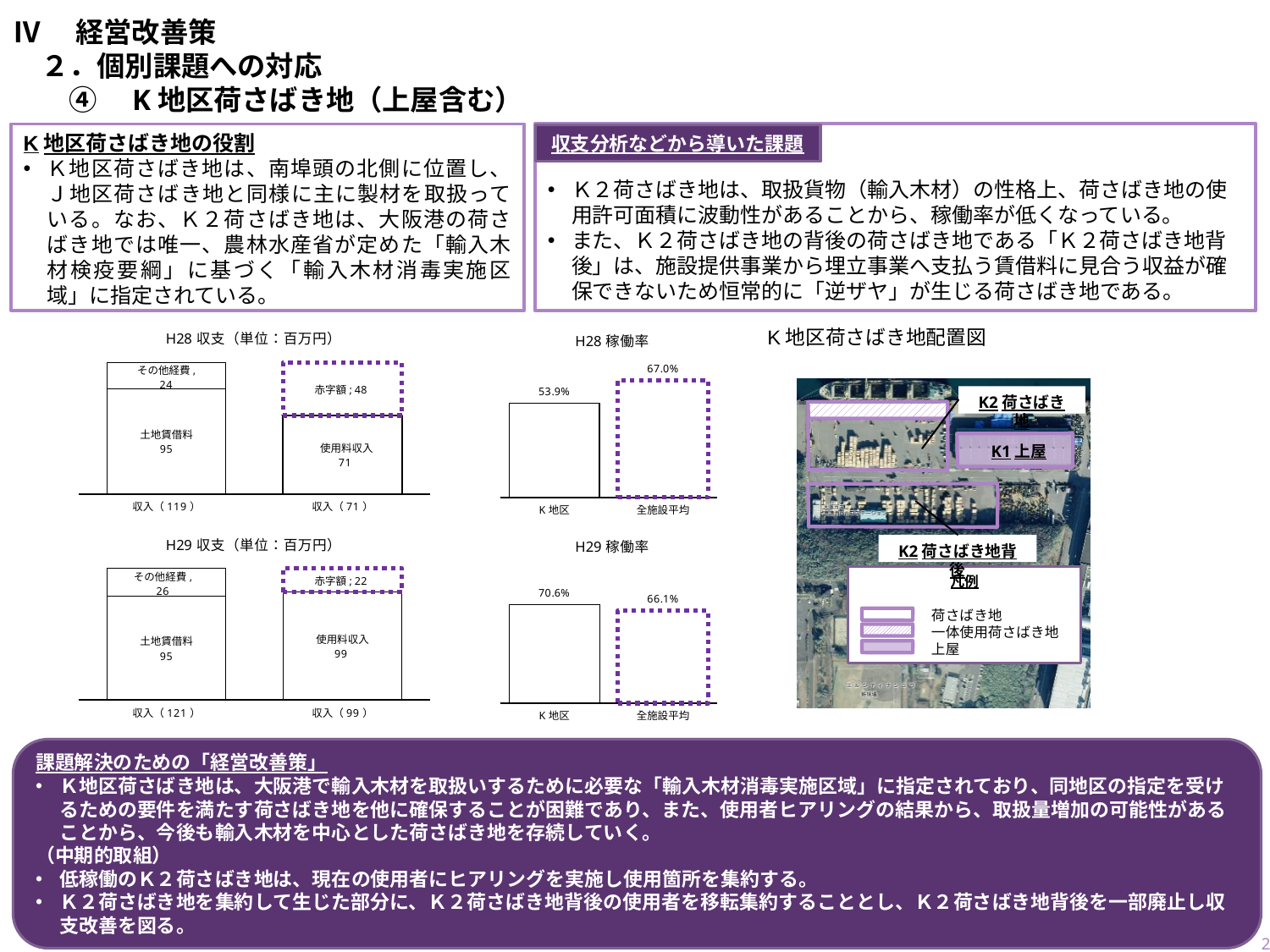
「H28 稼働率」のグラフで、K地区と全施設平均ではどちらが高いですか。 全施設平均 「H28 収支（単位：百万円）」のグラフで、その他経費と土地賃借料の合計はいくらですか。 119 「H29 稼働率」のグラフで、K地区と全施設平均の差は何ポイントですか。 4.5 「H29 稼働率」のグラフで、全施設平均の稼働率は何％ですか。 66.1% 「H28 稼働率」のグラフはどの種類のグラフですか。 棒グラフ 「H28 収支（単位：百万円）」のグラフで、赤字額はいくらですか。 48 「H28 稼働率」のグラフで、K地区の稼働率は何％ですか。 53.9% 「H29 稼働率」のグラフには、いくつのカテゴリがありますか。 2 「H28 収支（単位：百万円）」のグラフで、土地賃借料の値はいくらですか。 95 「H29 収支（単位：百万円）」のグラフで、土地賃借料と使用料収入の差はいくらですか。 4 「H29 収支（単位：百万円）」のグラフで、使用料収入の値はいくらですか。 99 「H29 収支（単位：百万円）」のグラフで、その他経費の値はいくらですか。 26